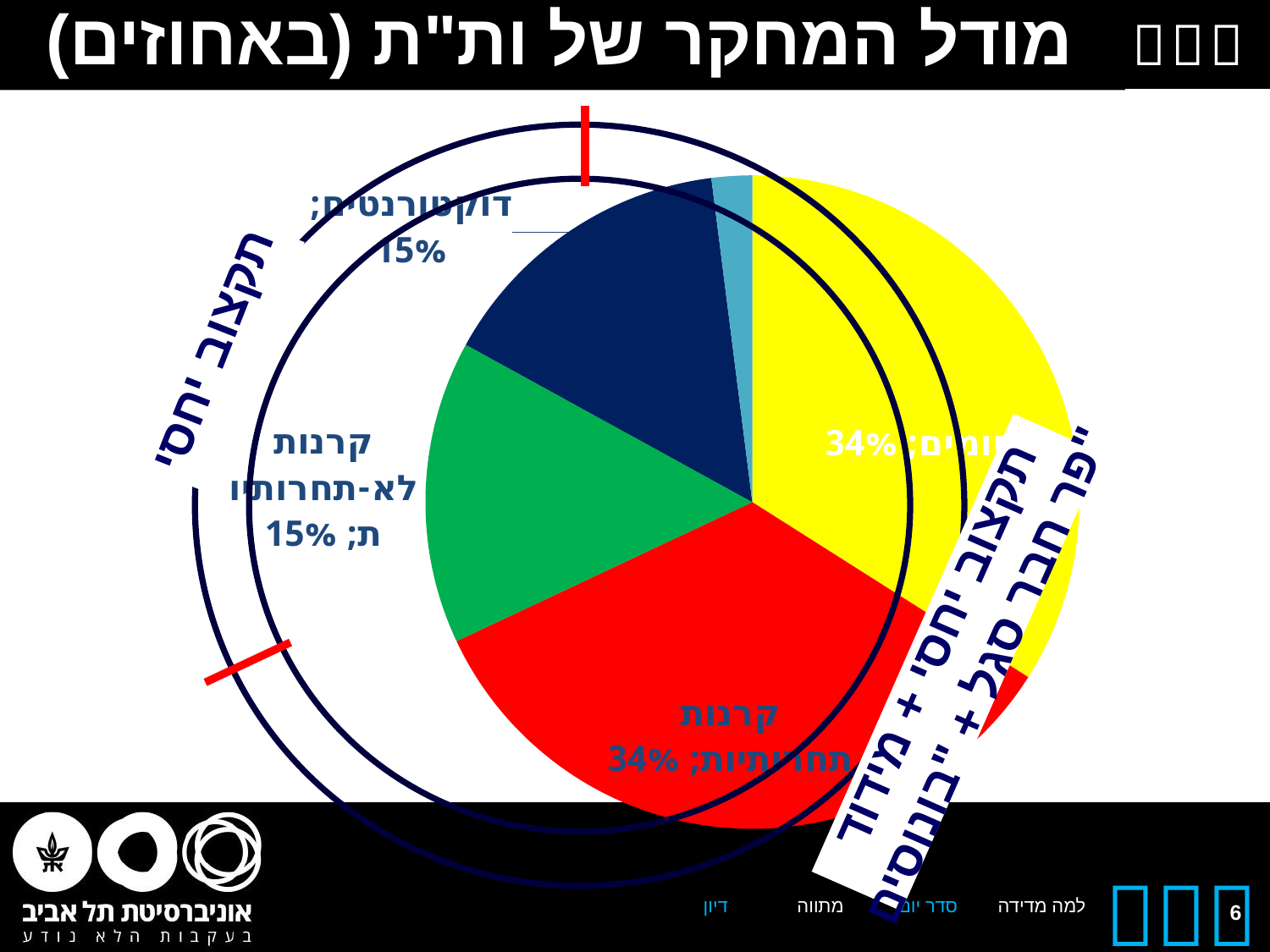
What is the title of the slide containing the pie chart? מודל המחקר של ות"ת (באחוזים) What percentage is shown for the slice labelled קרנות לא-תחרותיות (non-competitive funds)? 15% What share of the pie does the דוקטורנטים (doctoral students) slice represent? 15% What kind of chart is shown on the slide? pie chart What is the difference in percentage points between the קרנות תחרותיות slice and the דוקטורנטים slice? 19 How many slices does the pie chart have? 5 What percentage is shown for the yellow slice of the pie? 34% What percentage is shown for the slice labelled קרנות תחרותיות (competitive funds)? 34% Which slice is larger: קרנות תחרותיות (competitive funds) or קרנות לא-תחרותיות (non-competitive funds)? קרנות תחרותיות (competitive funds) What colour is the slice labelled קרנות תחרותיות (competitive funds)? red What percentage is shown for the slice labelled דוקטורנטים (doctoral students)? 15%